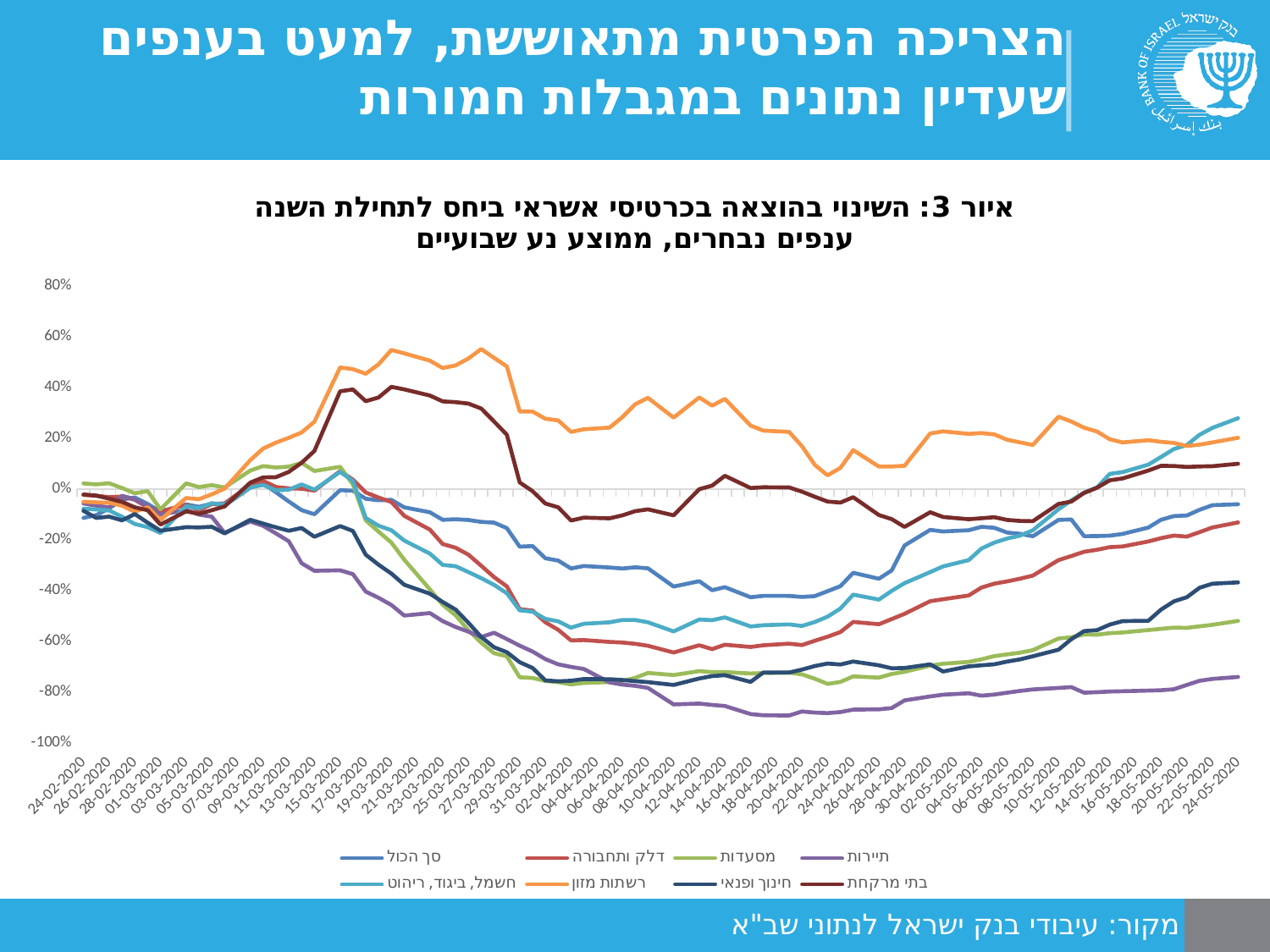
Is the peak value of רשתות מזון in late March greater or less than 40%? greater Does the תיירות series rise or fall between 15-03-2020 and 18-04-2020? fall Is the value for תיירות on 24-05-2020 greater or less than -60%? less How many series does the legend list? 8 What kind of chart is shown on the slide? line chart Which series is plotted in orange? רשתות מזון Is the value for חשמל, ביגוד, ריהוט on 24-05-2020 greater or less than 0%? greater What is the figure number given in the chart title? איור 3 Does the מסעדות series rise or fall between 31-03-2020 and 24-05-2020? rise Which series has the lowest value at the last date, 24-05-2020? תיירות On 24-05-2020, which is higher: רשתות מזון or תיירות? רשתות מזון